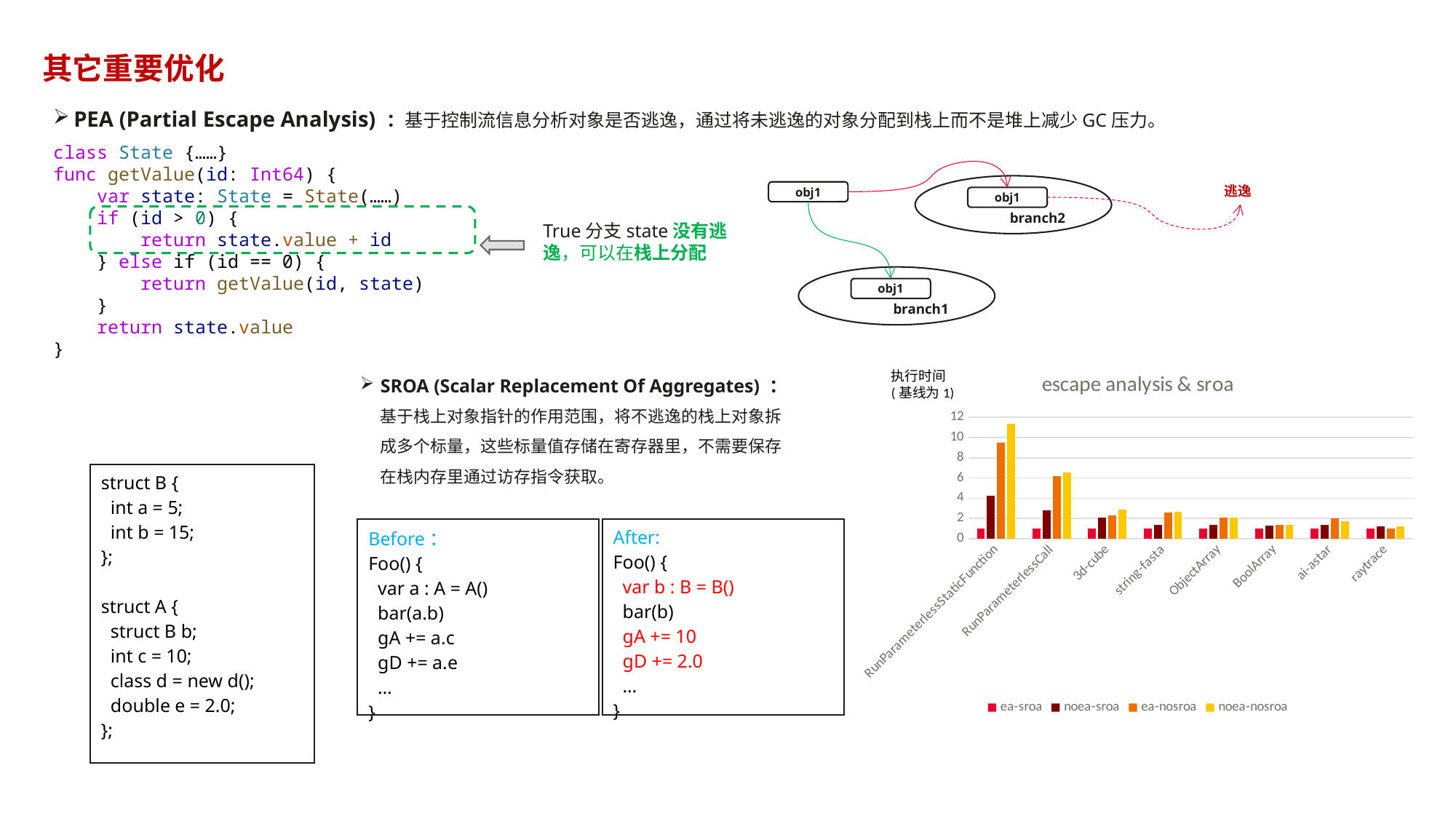
In the "escape analysis & sroa" chart, which series has the highest value for RunParameterlessStaticFunction? noea-nosroa In the "escape analysis & sroa" chart, which category has the tallest bar? RunParameterlessStaticFunction What is the title of the chart on the slide? escape analysis & sroa In the "escape analysis & sroa" chart, which is larger for 3d-cube: the ea-sroa value or the noea-nosroa value? noea-nosroa In the "escape analysis & sroa" chart, is the ea-nosroa value for RunParameterlessCall greater or less than 4? greater In the "escape analysis & sroa" chart, is the noea-nosroa value for raytrace greater or less than 2? less What kind of chart is the "escape analysis & sroa" chart? bar chart What are the legend entries of the "escape analysis & sroa" chart? ea-sroa, noea-sroa, ea-nosroa, noea-nosroa In the "escape analysis & sroa" chart, which is larger: the noea-nosroa value for RunParameterlessStaticFunction or for RunParameterlessCall? RunParameterlessStaticFunction How many categories are shown on the x axis of the "escape analysis & sroa" chart? 8 In the "escape analysis & sroa" chart, is the noea-nosroa value for RunParameterlessStaticFunction greater or less than 10? greater How many series does the legend of the "escape analysis & sroa" chart list? 4